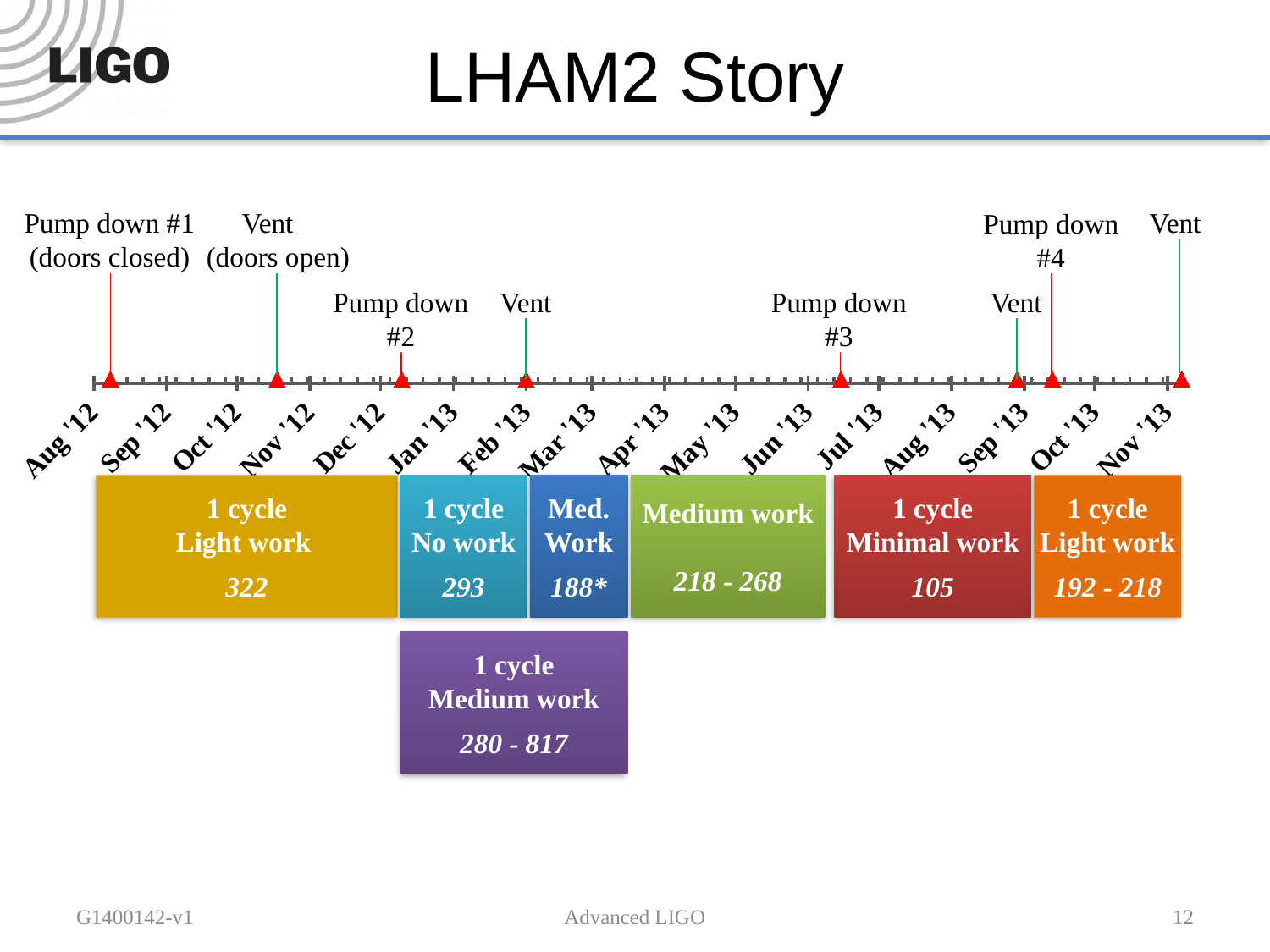
How many pump down events are marked on the timeline? 4 What range is printed in the 'Medium work' box spanning Apr '13 to Jul '13? 218 - 268 What range is printed in the '1 cycle Light work' box at the right end of the timeline (Oct '13 to Nov '13)? 192 - 218 What is the difference between the '1 cycle Light work' value of 322 and the '1 cycle No work' value of 293? 29 How many month labels are shown along the timeline axis? 16 What value is printed in the '1 cycle No work' box? 293 What range is printed in the '1 cycle Medium work' box below the timeline? 280 - 817 What kind of chart is shown on the slide? Timeline Which is larger, the value in the '1 cycle Light work' box (322) or the '1 cycle No work' box (293)? 1 cycle Light work (322) What value is printed in the '1 cycle Minimal work' box? 105 What value is printed in the first '1 cycle Light work' box (Aug '12 to Jan '13)? 322 What is the first month label on the timeline axis? Aug '12